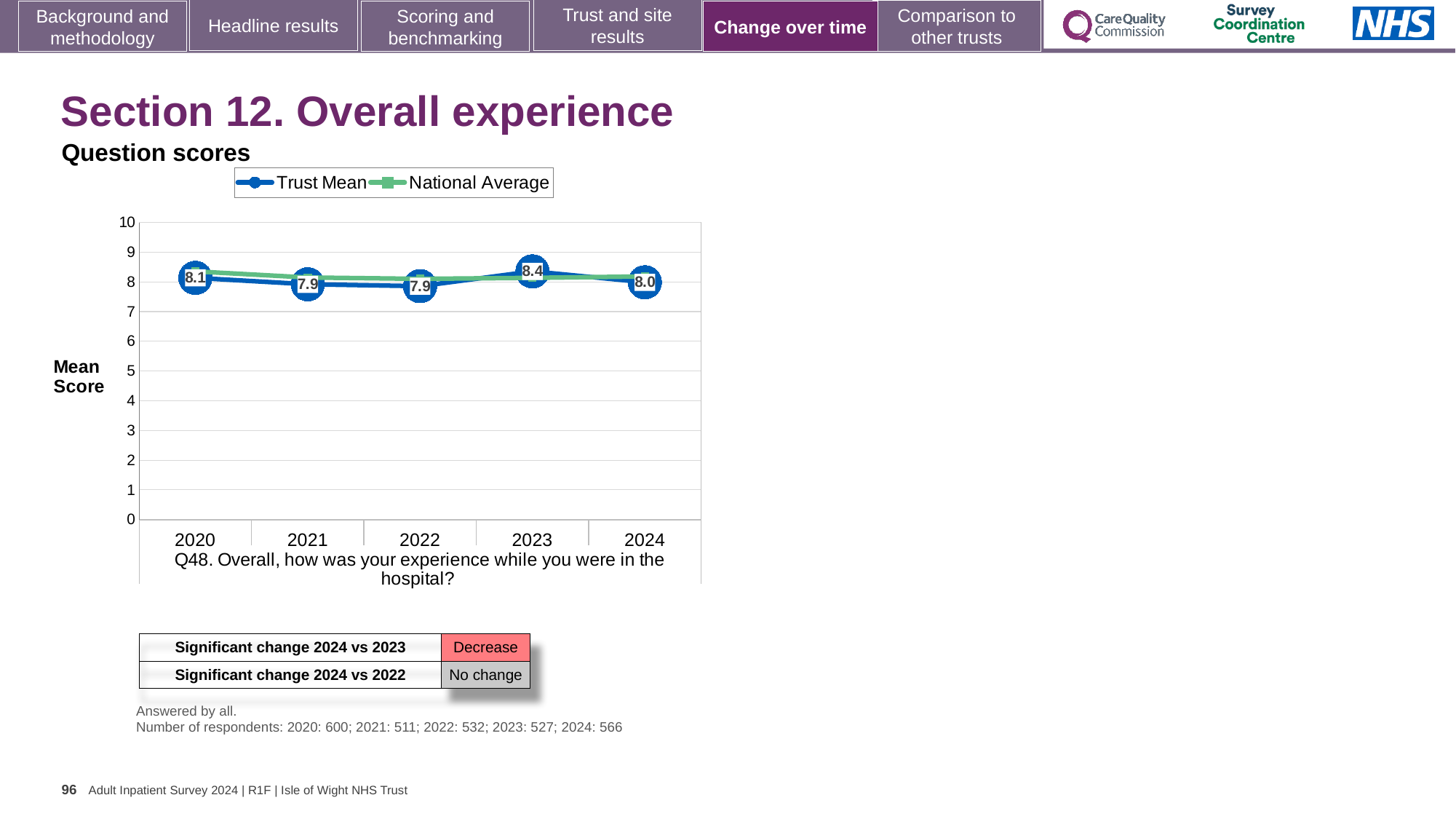
What kind of chart is shown? line chart What is the Trust Mean score for 2024? 8.0 How many years are shown on the x axis? 5 What is the Trust Mean score for 2020? 8.1 What is the difference between the Trust Mean scores for 2023 and 2024? 0.4 Which is larger, the Trust Mean score for 2020 or for 2021? 2020 What is the Trust Mean score for 2023? 8.4 In which year is the Trust Mean score highest? 2023 How many series does the legend list? 2 Does the Trust Mean score rise or fall from 2023 to 2024? fall Is the Trust Mean score for 2022 greater or less than 9? less What is the label on the y axis? Mean Score